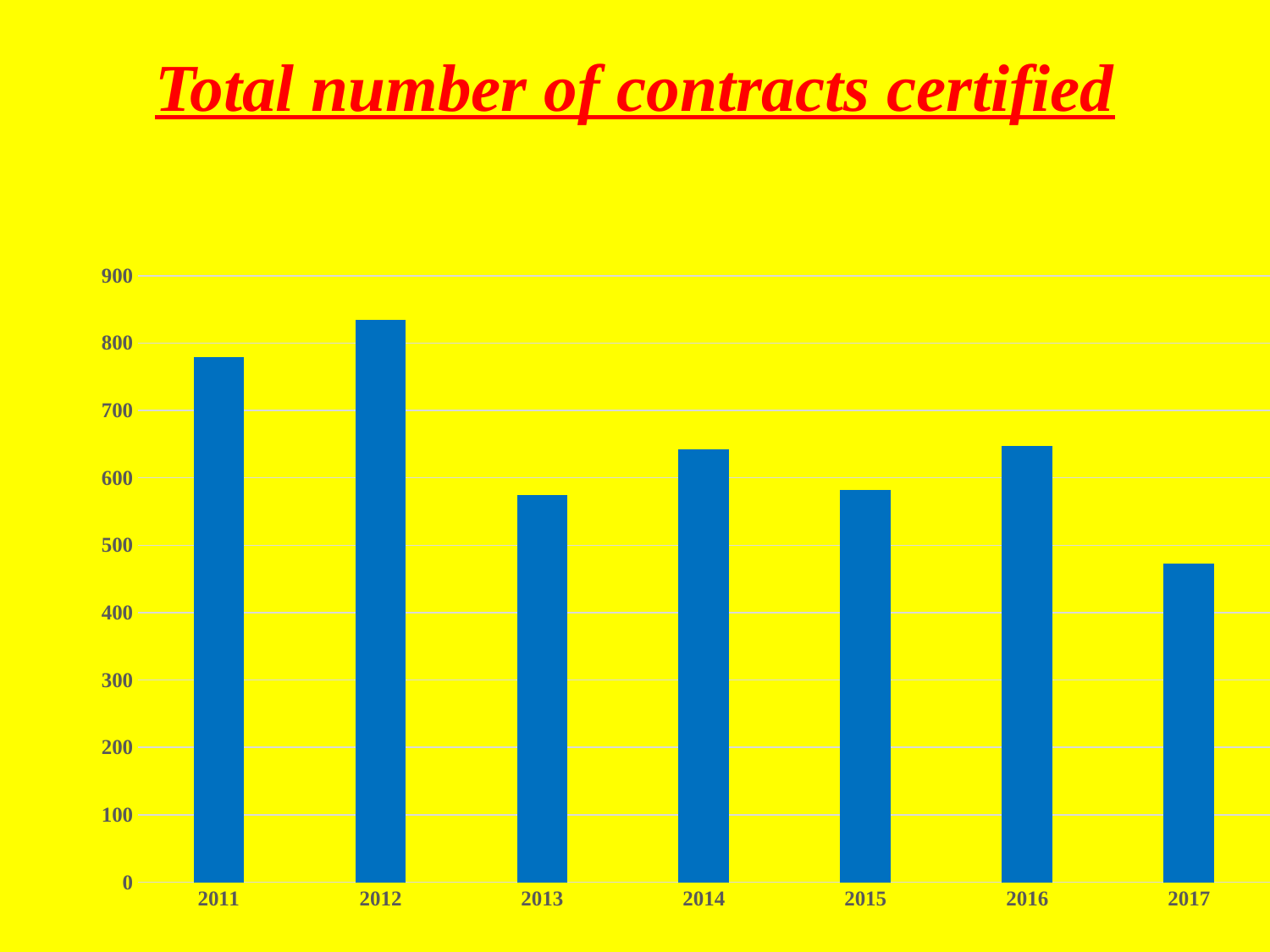
Is the value for 2017 greater or less than 500? less What is the title of the chart? Total number of contracts certified Is the value for 2012 greater or less than 800? greater Which year has the highest number of contracts certified? 2012 Is the value for 2011 greater or less than 700? greater Does the value rise or fall from 2016 to 2017? fall What kind of chart is shown on the slide? bar chart Which year has the larger value, 2011 or 2013? 2011 Which year has the lowest number of contracts certified? 2017 How many years are shown on the x axis? 7